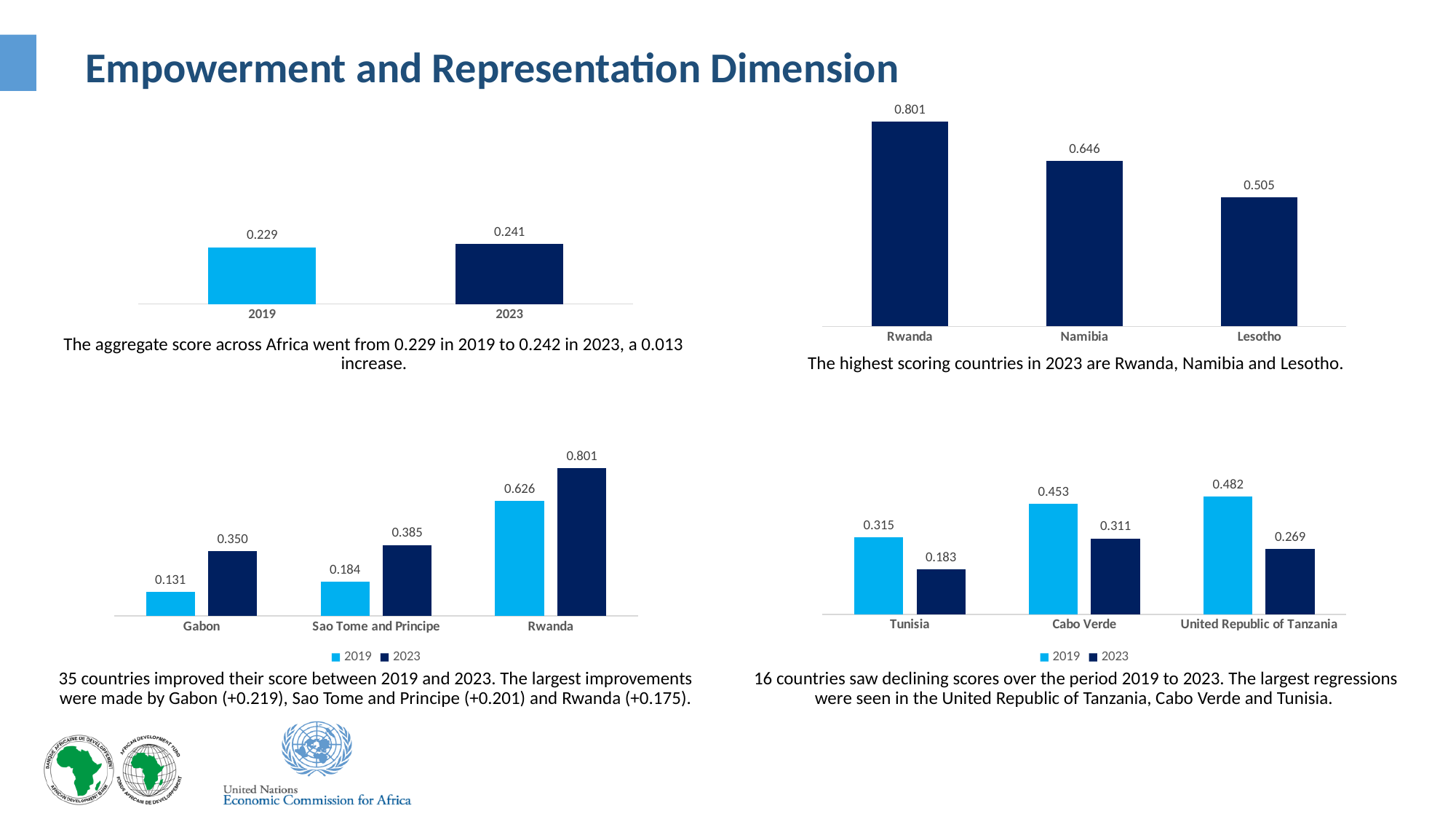
In the bottom-right chart, what is the 2023 value for Tunisia? 0.183 In the top-right chart, which country has the highest value? Rwanda What kind of chart is the top-right chart? bar chart In the top-right chart, what is the value for Namibia? 0.646 In the top-left chart, what is the value for 2023? 0.241 In the bottom-left chart, what is the 2019 value for Sao Tome and Principe? 0.184 In the bottom-left chart, how many series does the legend list? 2 In the top-right chart, how many countries are shown? 3 In the top-left chart, what is the difference between the 2023 and 2019 values? 0.012 In the bottom-right chart, is the 2019 value for Cabo Verde larger or smaller than its 2023 value? larger In the bottom-right chart, which country has the highest 2019 value? United Republic of Tanzania In the bottom-left chart, what is the difference between the 2023 and 2019 values for Gabon? 0.219